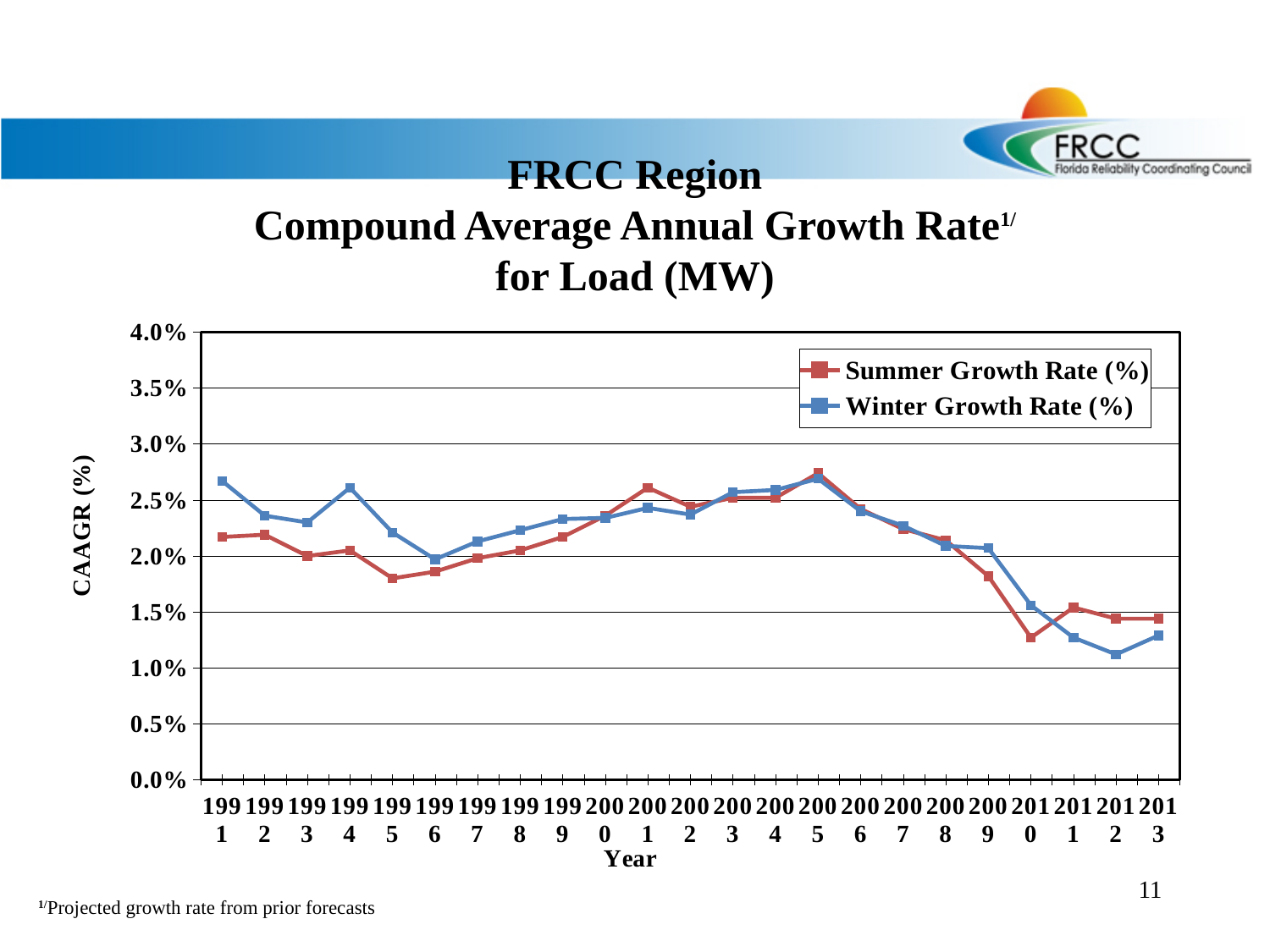
What kind of chart is shown on the slide? Line chart Is the Summer Growth Rate (%) for 1995 greater or less than 2.0%? less In 1991, which is larger: the Summer Growth Rate (%) or the Winter Growth Rate (%)? Winter Growth Rate (%) Is the Winter Growth Rate (%) for 2012 greater or less than 1.5%? less Which year has the highest Summer Growth Rate (%)? 2005 Which year has the lowest Winter Growth Rate (%)? 2012 How many years are plotted along the x axis? 23 Is the Winter Growth Rate (%) for 1991 greater or less than 2.5%? greater Does the Summer Growth Rate (%) rise or fall from 2005 to 2010? Fall In 2011, which is larger: the Summer Growth Rate (%) or the Winter Growth Rate (%)? Summer Growth Rate (%) Which year has the lowest Summer Growth Rate (%)? 2010 How many series does the legend list? 2